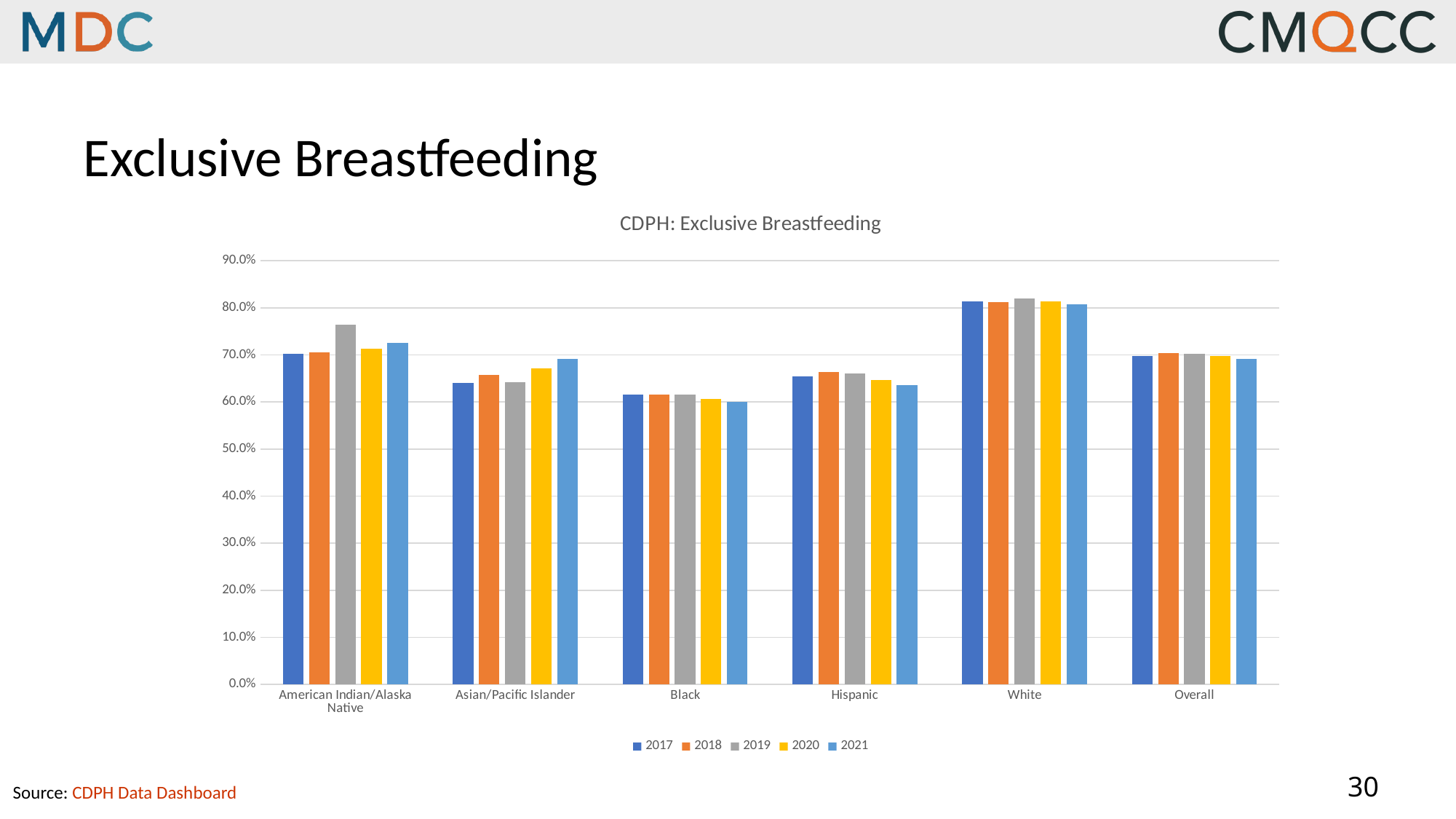
Which category has the highest exclusive breastfeeding values across all years? White Which category has the lowest exclusive breastfeeding values across all years? Black What kind of chart is shown on the slide? Bar chart Is the 2017 value for Black greater or less than 70.0%? less Which colour represents 2020 in the legend? Yellow How many series does the legend list? 5 Is the 2019 value for American Indian/Alaska Native greater or less than 70.0%? greater Which is larger, the 2019 value for White or the 2019 value for Overall? White Which is larger, the 2021 value for Hispanic or the 2021 value for Black? Hispanic How many categories are shown on the x axis? 6 What is the title of the chart? CDPH: Exclusive Breastfeeding Is the 2019 value for White greater or less than 80.0%? greater